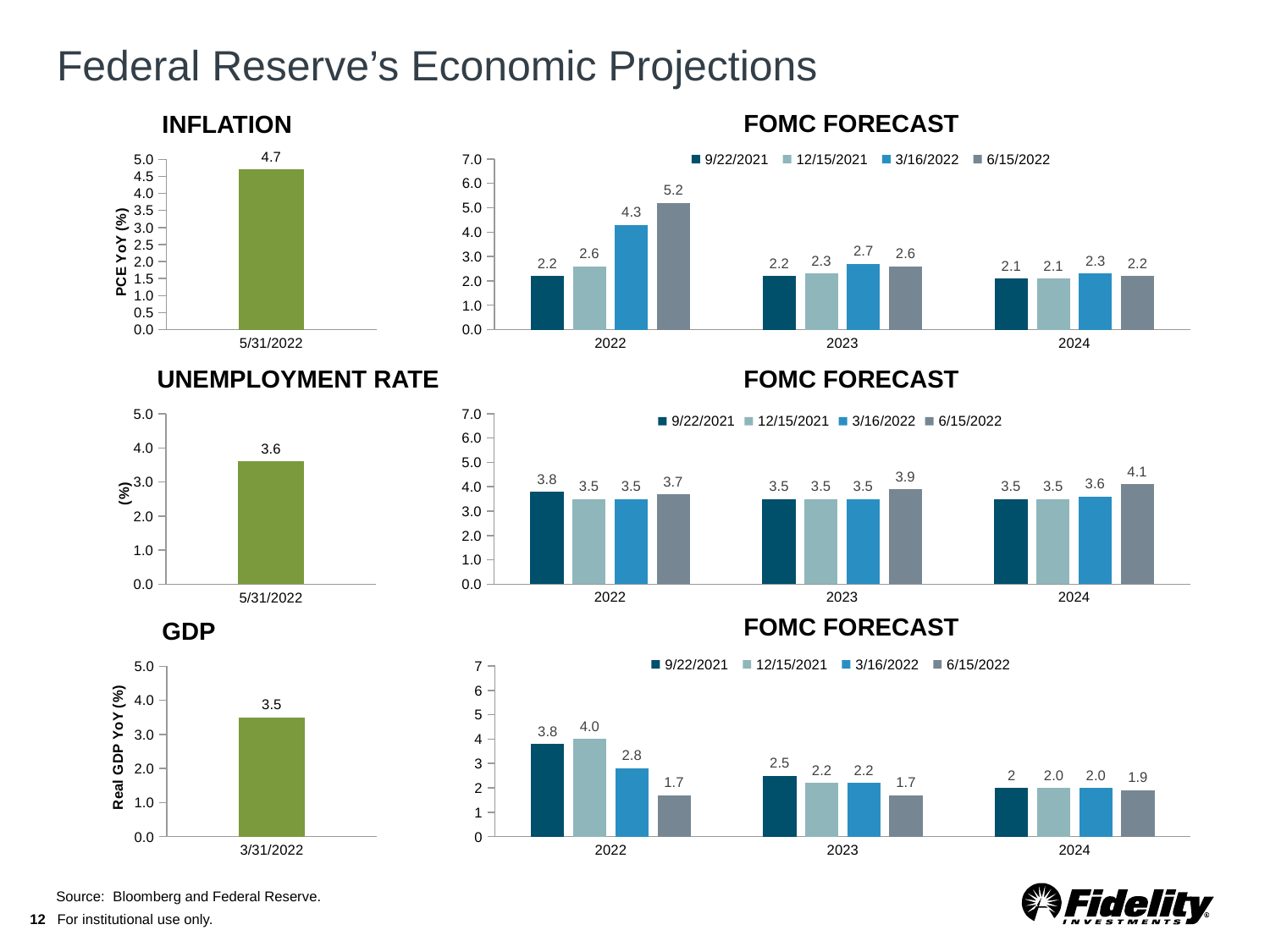
On the middle-right FOMC FORECAST chart (next to UNEMPLOYMENT RATE), is the 6/15/2022 value for 2023 larger or smaller than the 3/16/2022 value for 2023? larger On the bottom-right FOMC FORECAST chart (next to GDP), do the values for 2022 rise or fall from the 9/22/2021 series to the 6/15/2022 series? fall On the top-right FOMC FORECAST chart (next to INFLATION), what is the difference between the 6/15/2022 and 9/22/2021 values for 2022? 3.0 On the GDP chart, what is the Real GDP YoY value shown for 3/31/2022? 3.5 How many series does the legend list on the middle-right FOMC FORECAST chart (next to UNEMPLOYMENT RATE)? 4 What kind of chart is the GDP chart on the left? bar chart On the bottom-right FOMC FORECAST chart (next to GDP), what is the 12/15/2021 value for 2022? 4.0 On the UNEMPLOYMENT RATE chart, what is the value shown for 5/31/2022? 3.6 On the top-right FOMC FORECAST chart (next to INFLATION), what is the 6/15/2022 value for 2022? 5.2 On the top-right FOMC FORECAST chart (next to INFLATION), which forecast date has the highest value for 2022? 6/15/2022 On the middle-right FOMC FORECAST chart (next to UNEMPLOYMENT RATE), what is the 6/15/2022 value for 2024? 4.1 On the INFLATION chart, what is the PCE YoY value shown for 5/31/2022? 4.7